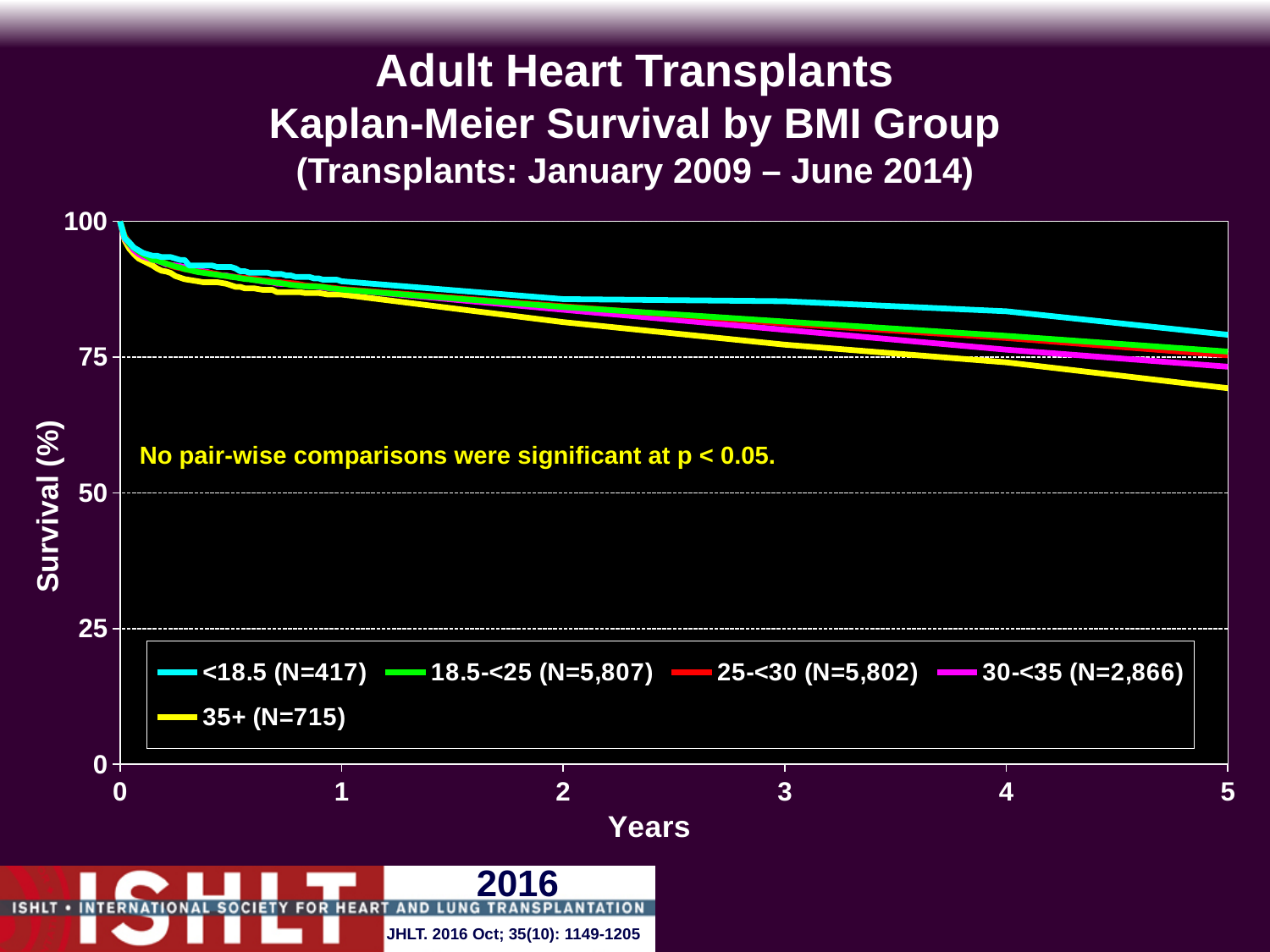
Which BMI group has the lowest survival at 5 years? 35+ (N=715) Is the survival for the 35+ group at 1 year greater or less than 75? greater What is the label of the x axis? Years How many patients (N) are in the 18.5-<25 BMI group according to the legend? 5,807 At 5 years, which has higher survival: the <18.5 group or the 35+ group? <18.5 (N=417) Is the survival for the <18.5 group at 5 years greater or less than 75? greater Do the survival curves rise or fall as years increase? fall Is the survival for the 35+ group at 5 years greater or less than 75? less Which BMI group has the highest survival at 5 years? <18.5 (N=417) How many series does the legend list? 5 What kind of chart is shown on the slide? line chart